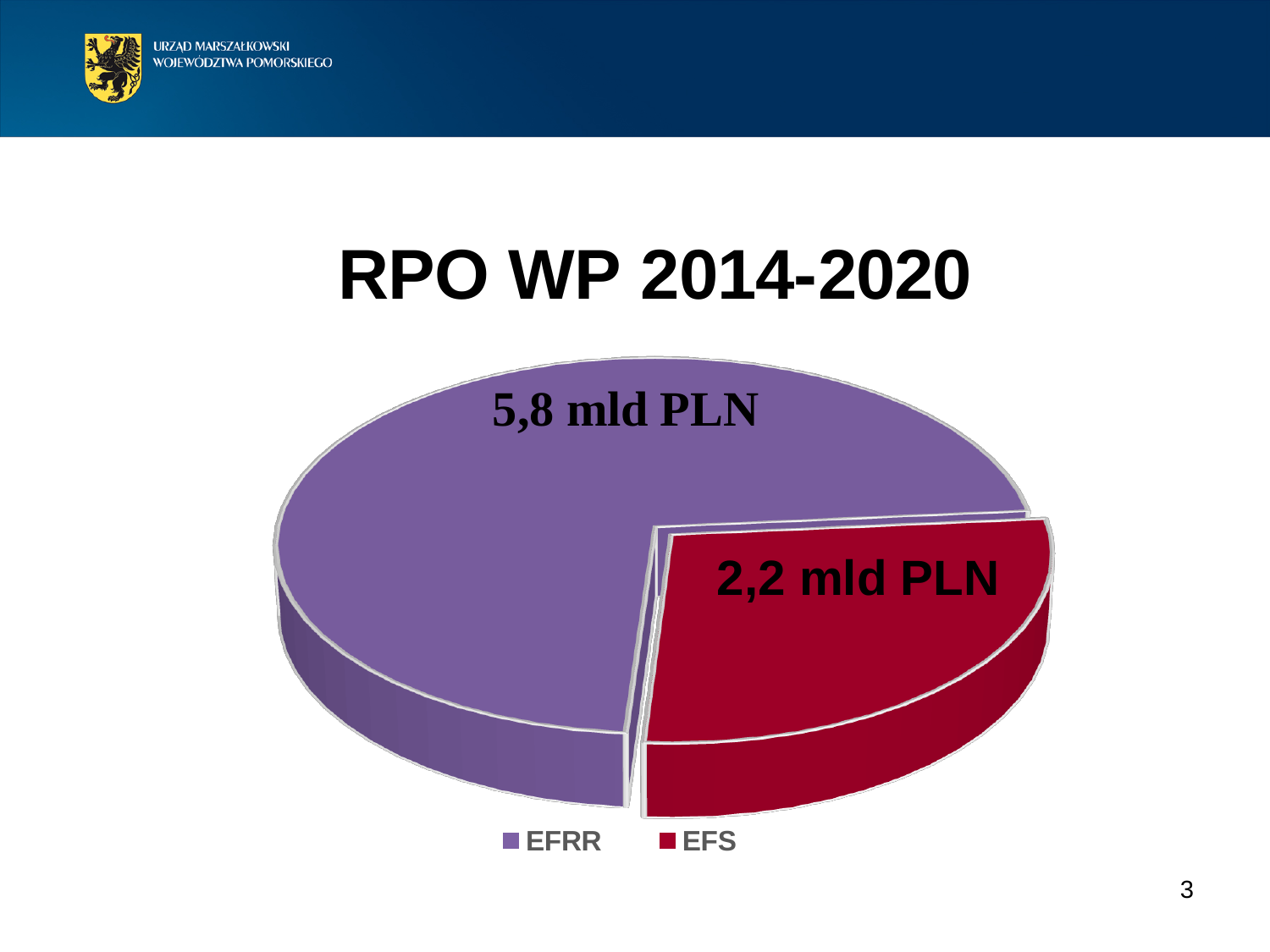
Which category has the smallest slice of the pie chart? EFS Which category has the largest slice of the pie chart? EFRR What is the title of the chart on the slide? RPO WP 2014-2020 How many entries does the legend of the chart list? 2 How many slices does the pie chart have? 2 What colour is the EFS slice in the pie chart? Red What is the value shown for EFRR in the pie chart? 5,8 mld PLN What kind of chart is shown on the slide? Pie chart Which is larger, the value for EFRR or the value for EFS? EFRR What is the combined total of the EFRR and EFS values shown in the pie chart? 8,0 mld PLN What is the difference between the EFRR value and the EFS value? 3,6 mld PLN What is the value shown for EFS in the pie chart? 2,2 mld PLN